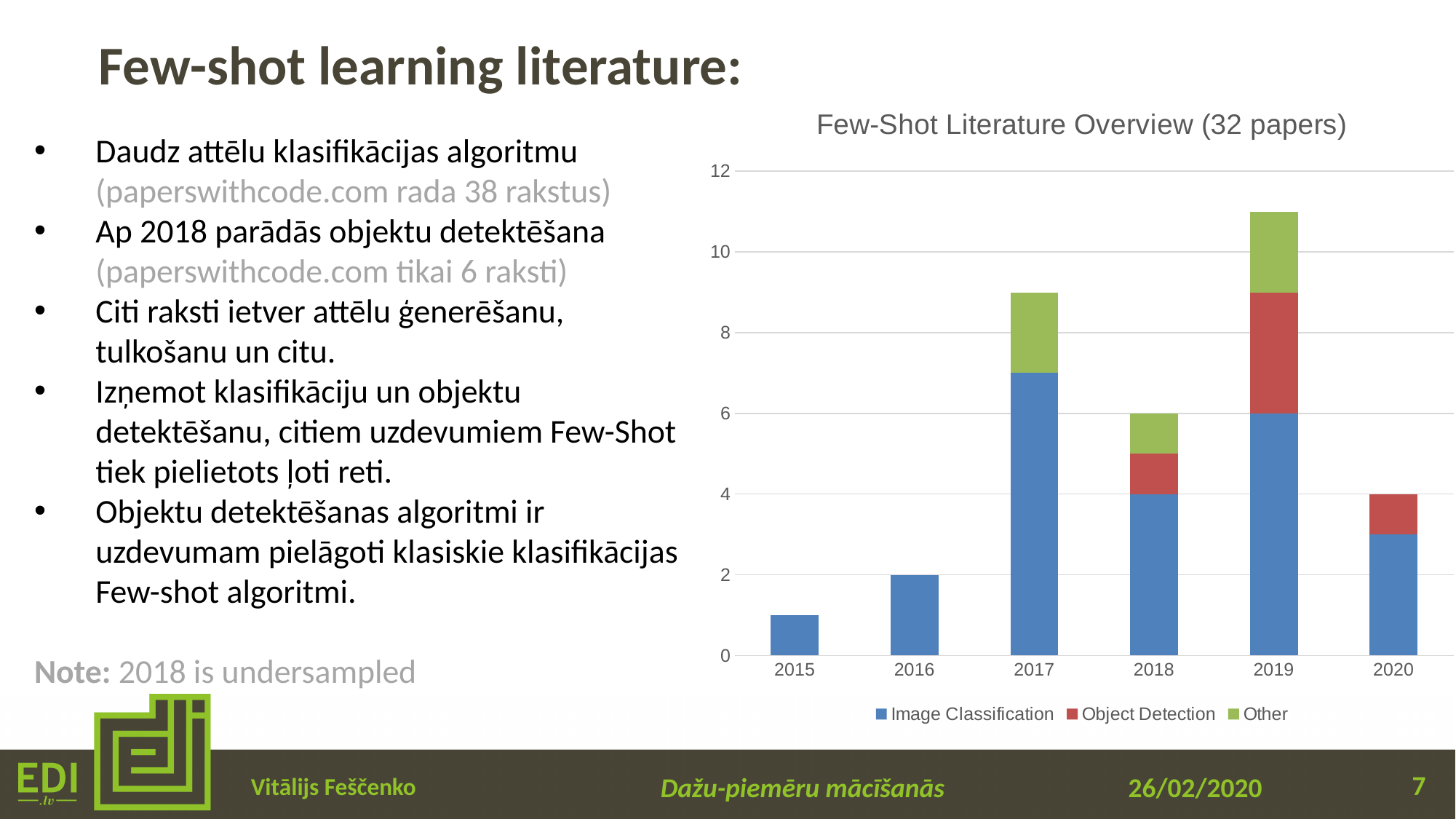
Which year has a larger total bar, 2017 or 2018? 2017 How many series does the legend list? 3 Which year has the lowest total bar? 2015 What is the total height of the bar for 2018? 6 What is the total height of the bar for 2016? 2 What kind of chart is shown on the slide? stacked bar chart Which year has the highest total bar? 2019 What is the title of the chart? Few-Shot Literature Overview (32 papers) What is the Image Classification value for 2019? 6 What is the difference between the total for 2018 and the total for 2016? 4 How many years are shown on the x axis? 6 Is the total for 2017 greater or less than 8? greater